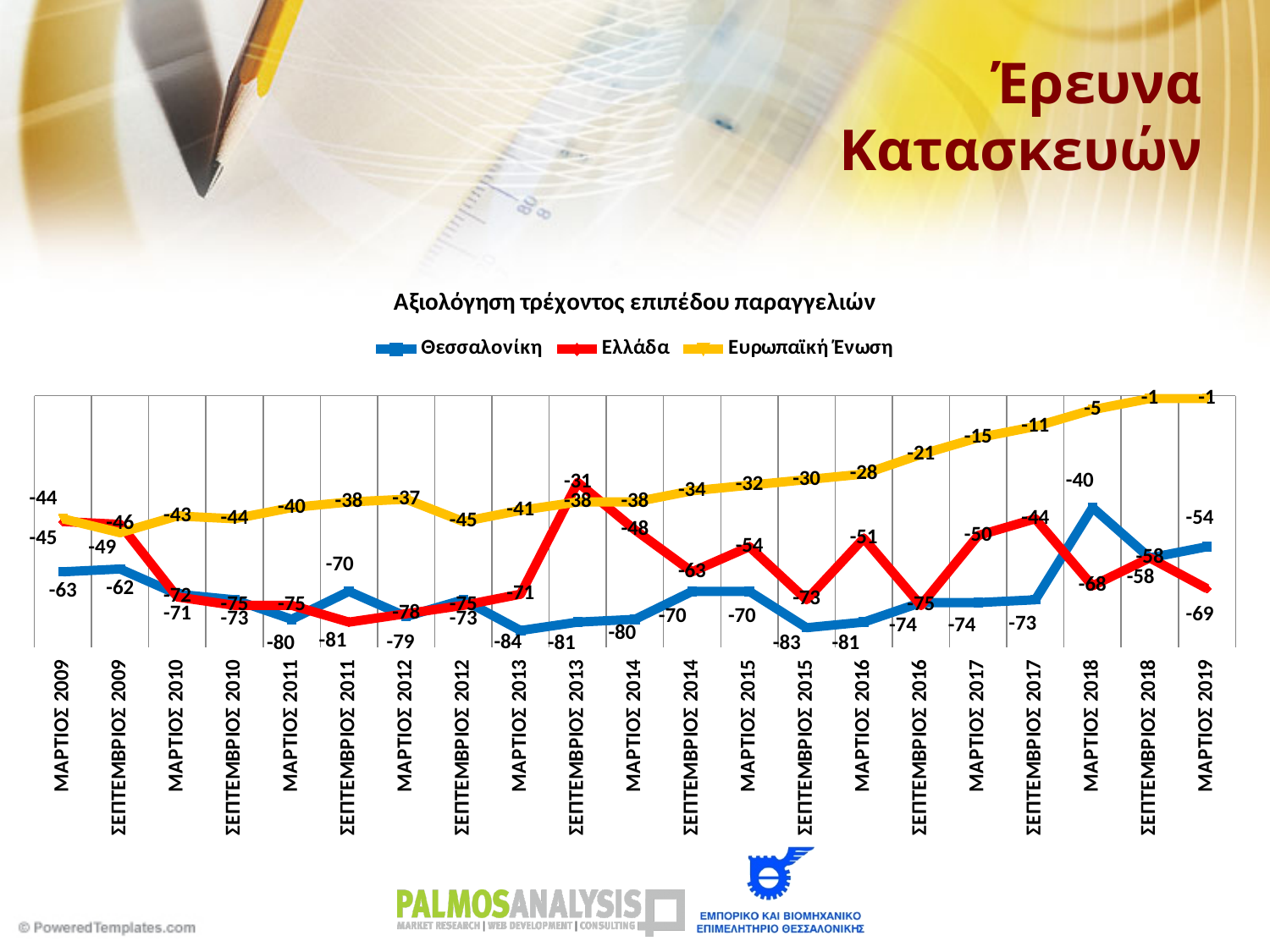
What is the value for Ελλάδα in ΜΑΡΤΙΟΣ 2019? -69 In ΜΑΡΤΙΟΣ 2018, which is higher: Θεσσαλονίκη or Ελλάδα? Θεσσαλονίκη What is the value for Θεσσαλονίκη in ΜΑΡΤΙΟΣ 2018? -40 Does the Ευρωπαϊκή Ένωση series generally rise or fall from ΜΑΡΤΙΟΣ 2009 to ΜΑΡΤΙΟΣ 2019? rise What is the difference between the Θεσσαλονίκη and Ελλάδα values in ΜΑΡΤΙΟΣ 2019? 15 In which period does the Ελλάδα series reach its highest value? ΣΕΠΤΕΜΒΡΙΟΣ 2013 What type of chart is shown on the slide? line chart How many time points are plotted along the x axis? 21 What is the value for Ευρωπαϊκή Ένωση in ΜΑΡΤΙΟΣ 2019? -1 How many series does the legend list? 3 In which period does the Θεσσαλονίκη series reach its highest value? ΜΑΡΤΙΟΣ 2018 What is the value for Ευρωπαϊκή Ένωση in ΣΕΠΤΕΜΒΡΙΟΣ 2016? -21